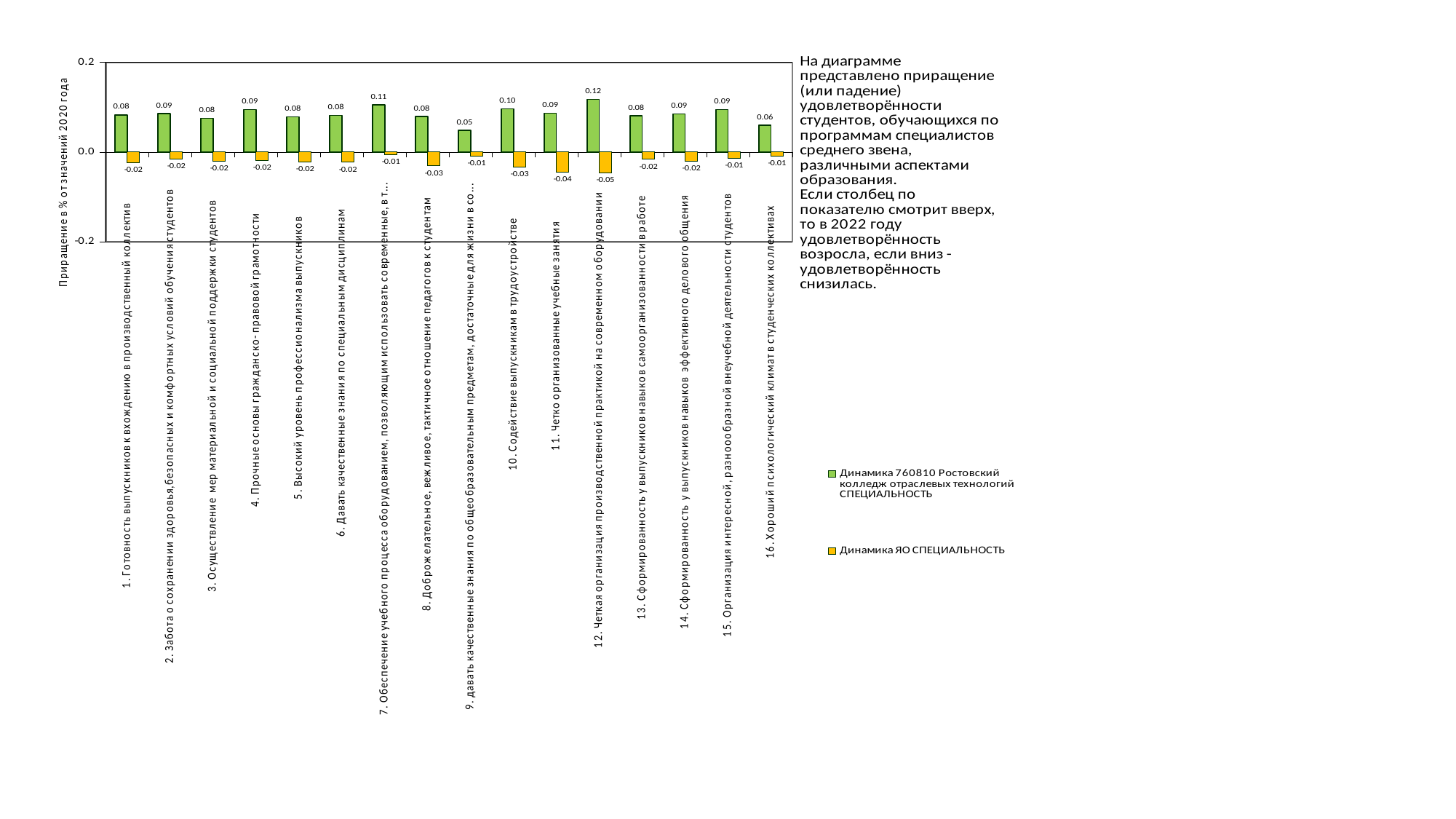
What is the value of the series "Динамика 760810 Ростовский колледж отраслевых технологий СПЕЦИАЛЬНОСТЬ" for category "12. Четкая организация производственной практикой на современном оборудовании"? 0.12 How many series does the legend list? 2 Which category has the lowest (most negative) value for the series "Динамика ЯО СПЕЦИАЛЬНОСТЬ"? 12. Четкая организация производственной практикой на современном оборудовании What is the value of the series "Динамика ЯО СПЕЦИАЛЬНОСТЬ" for category "11. Четко организованные учебные занятия"? -0.04 What is the value of the series "Динамика 760810 Ростовский колледж отраслевых технологий СПЕЦИАЛЬНОСТЬ" for category "16. Хороший психологический климат в студенческих коллективах"? 0.06 How many categories are plotted on the x axis? 16 Which category has the lowest value for the series "Динамика 760810 Ростовский колледж отраслевых технологий СПЕЦИАЛЬНОСТЬ"? 9. давать качественные знания по общеобразовательным предметам, достаточные для жизни в со... What type of chart is shown on the slide? bar chart What colour are the bars of the series "Динамика ЯО СПЕЦИАЛЬНОСТЬ"? yellow For the series "Динамика 760810 Ростовский колледж отраслевых технологий СПЕЦИАЛЬНОСТЬ", which is larger: the value for category "7. Обеспечение учебного процесса оборудованием..." or for category "10. Содействие выпускникам в трудоустройстве"? 7. Обеспечение учебного процесса оборудованием... Which category has the highest value for the series "Динамика 760810 Ростовский колледж отраслевых технологий СПЕЦИАЛЬНОСТЬ"? 12. Четкая организация производственной практикой на современном оборудовании What is the difference between the values of the series "Динамика 760810 Ростовский колледж отраслевых технологий СПЕЦИАЛЬНОСТЬ" for category 12 and category 9? 0.07